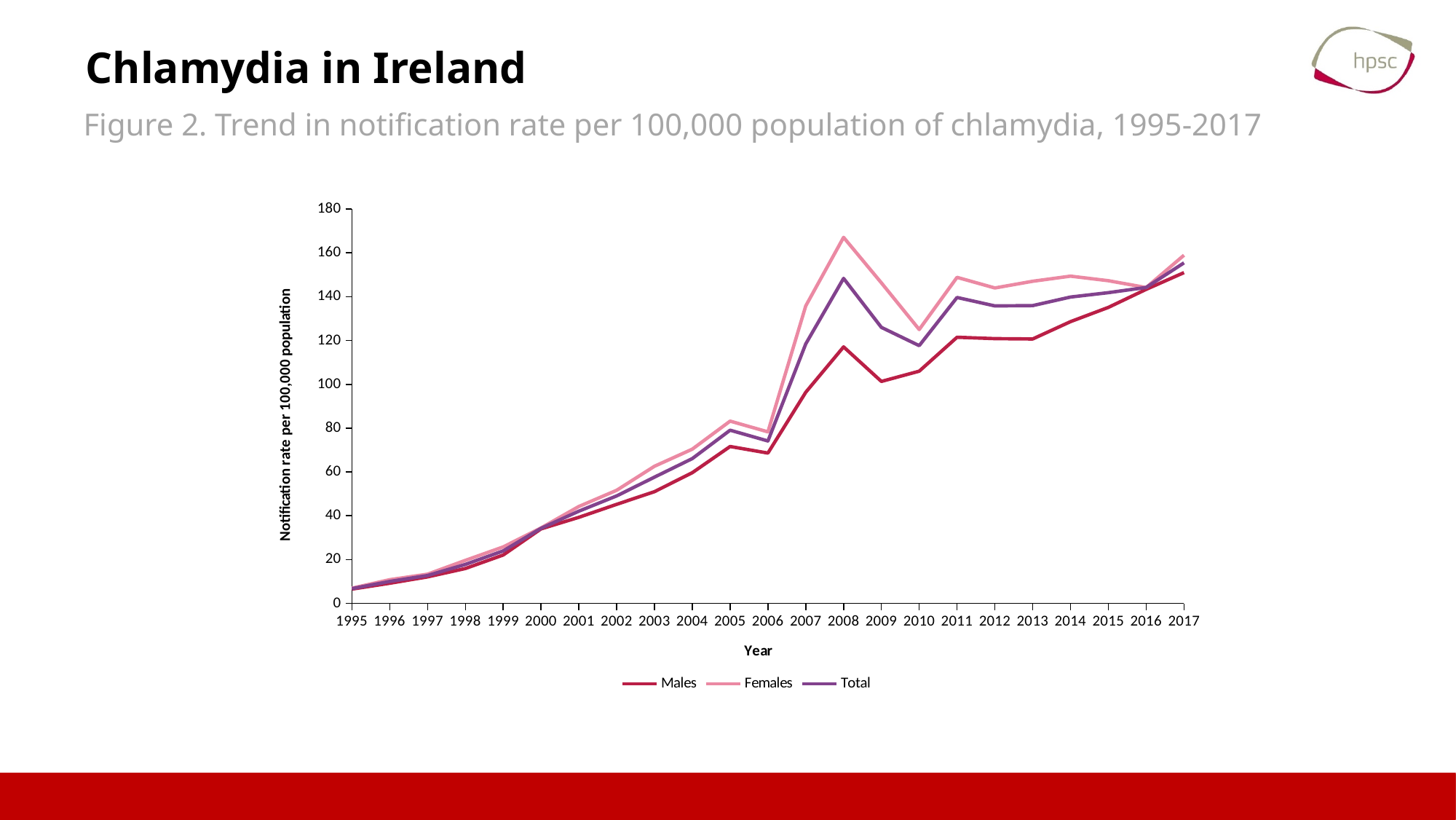
In which year does the Females line reach its highest value? 2008 Is the value for Males in 2006 greater or less than 80? less Is the value for Total in 2008 greater or less than 140? greater How many series does the legend list? 3 In which year does the Males line reach its highest value? 2017 In which year is the Total notification rate lowest? 1995 Which is larger in 2008, the Males value or the Females value? Females What kind of chart is shown on the slide? line chart What is the label on the y axis of the chart? Notification rate per 100,000 population How many years are plotted along the x axis? 23 Is the value for Females in 2008 greater or less than 160? greater Does the Total notification rate rise or fall between 1995 and 2008? rise